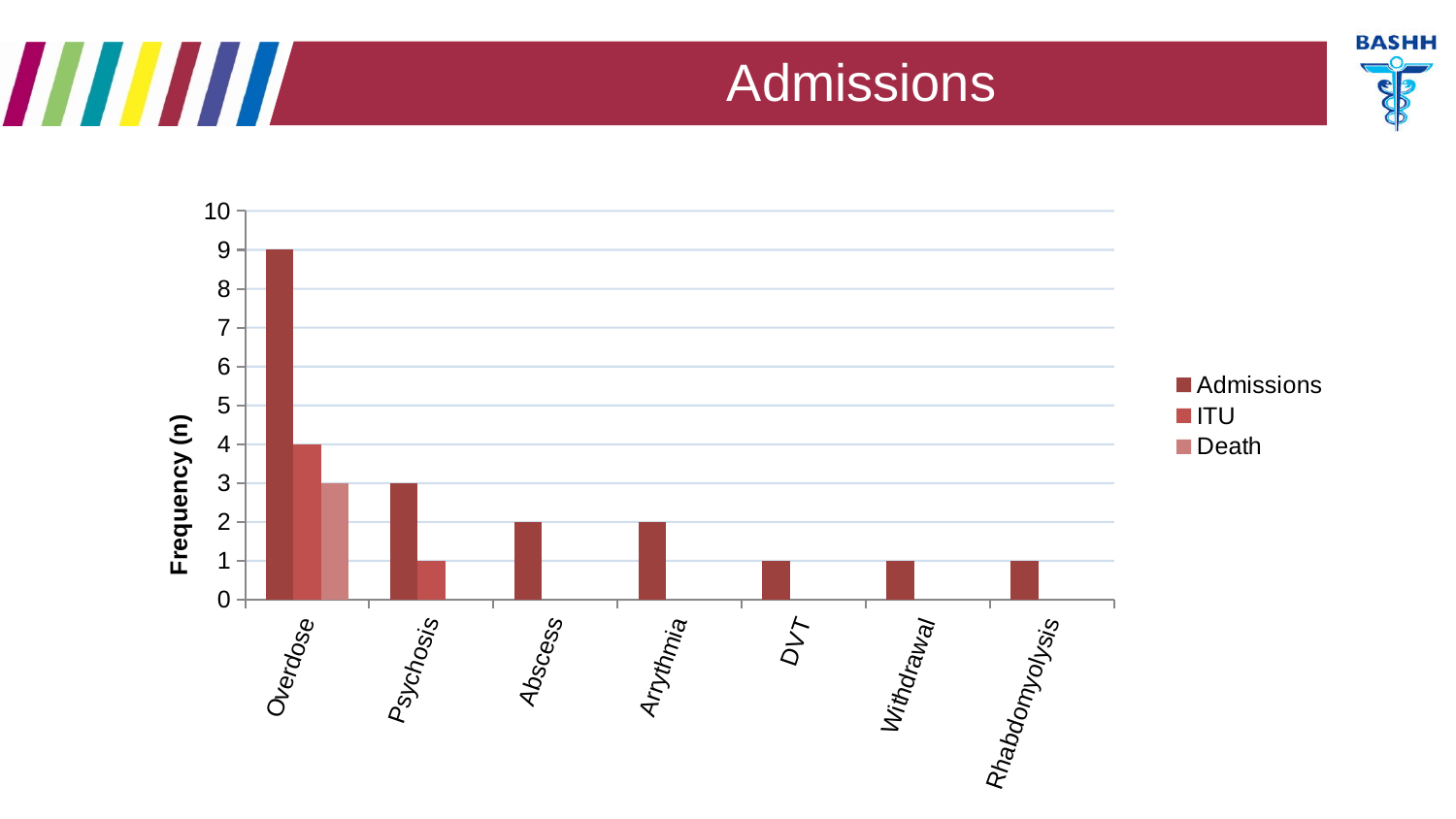
What type of chart is shown on the slide? bar chart How many series does the legend list? 3 What is the label of the y axis? Frequency (n) What is the Admissions value for Psychosis? 3 What is the Death value for Overdose? 3 Which category has the highest Admissions value? Overdose What is the difference between the Admissions values for Overdose and Psychosis? 6 What is the ITU value for Overdose? 4 Which is larger, the Admissions value for Abscess or the Admissions value for DVT? Abscess What is the Admissions value for Overdose? 9 How many categories are shown on the x axis? 7 Is the Admissions value for Overdose greater or less than 5? greater